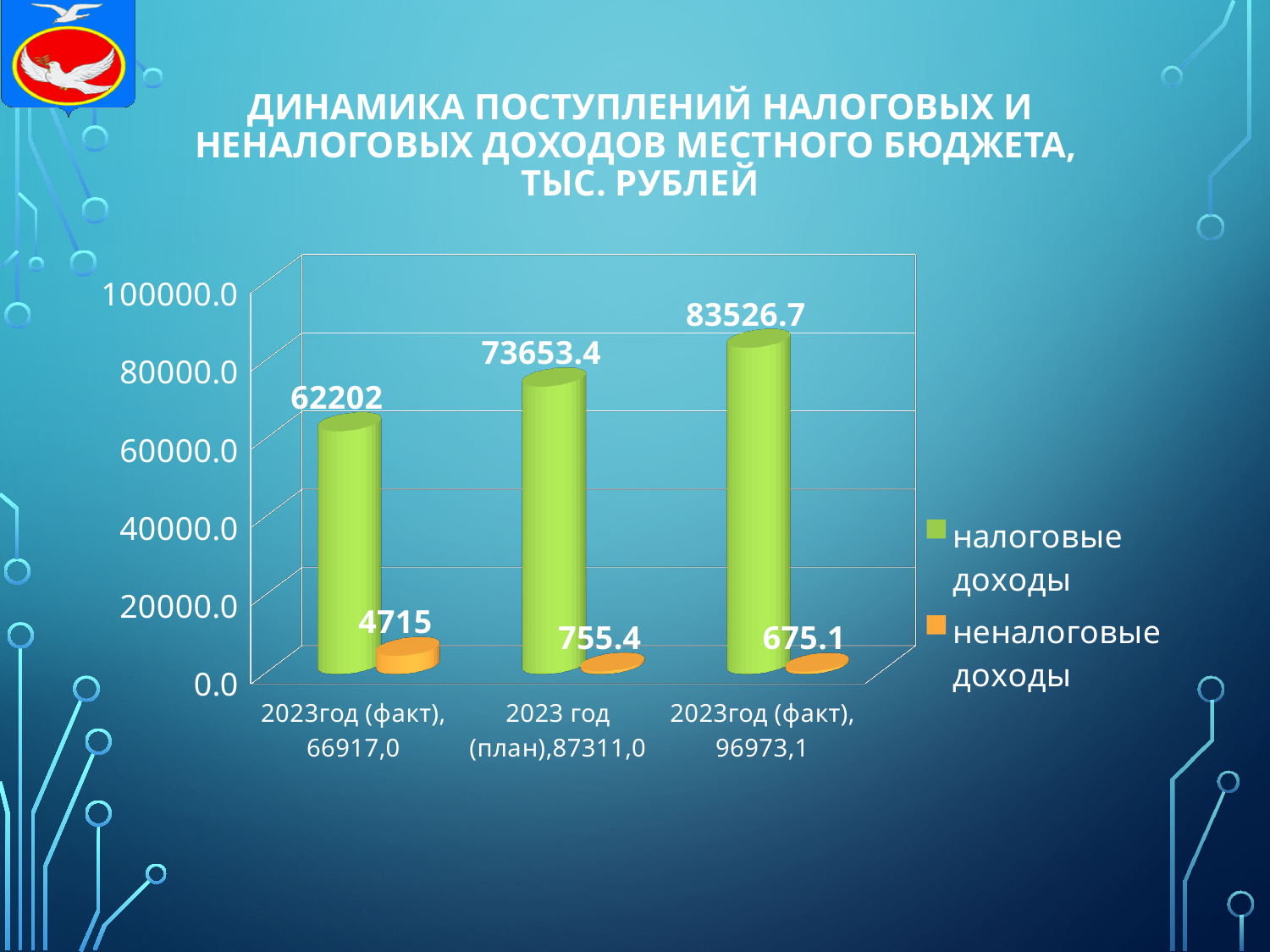
Which category has the lowest value of неналоговые доходы? 2023год (факт), 96973,1 What is the value of налоговые доходы for the category "2023год (факт), 66917,0"? 62202 What is the difference between налоговые доходы for "2023год (факт), 96973,1" and for "2023 год (план),87311,0"? 9873.3 How many categories are shown on the x axis? 3 Is the value of налоговые доходы for "2023год (факт), 96973,1" greater or less than 80000.0? greater What is the value of неналоговые доходы for the category "2023год (факт), 96973,1"? 675.1 What kind of chart is shown on the slide? Bar chart Which is larger: неналоговые доходы for "2023 год (план),87311,0" or for "2023год (факт), 96973,1"? 2023 год (план),87311,0 What is the value of неналоговые доходы for the category "2023год (факт), 66917,0"? 4715 What is the value of налоговые доходы for the category "2023 год (план),87311,0"? 73653.4 How many series does the legend list? 2 Which category has the highest value of налоговые доходы? 2023год (факт), 96973,1